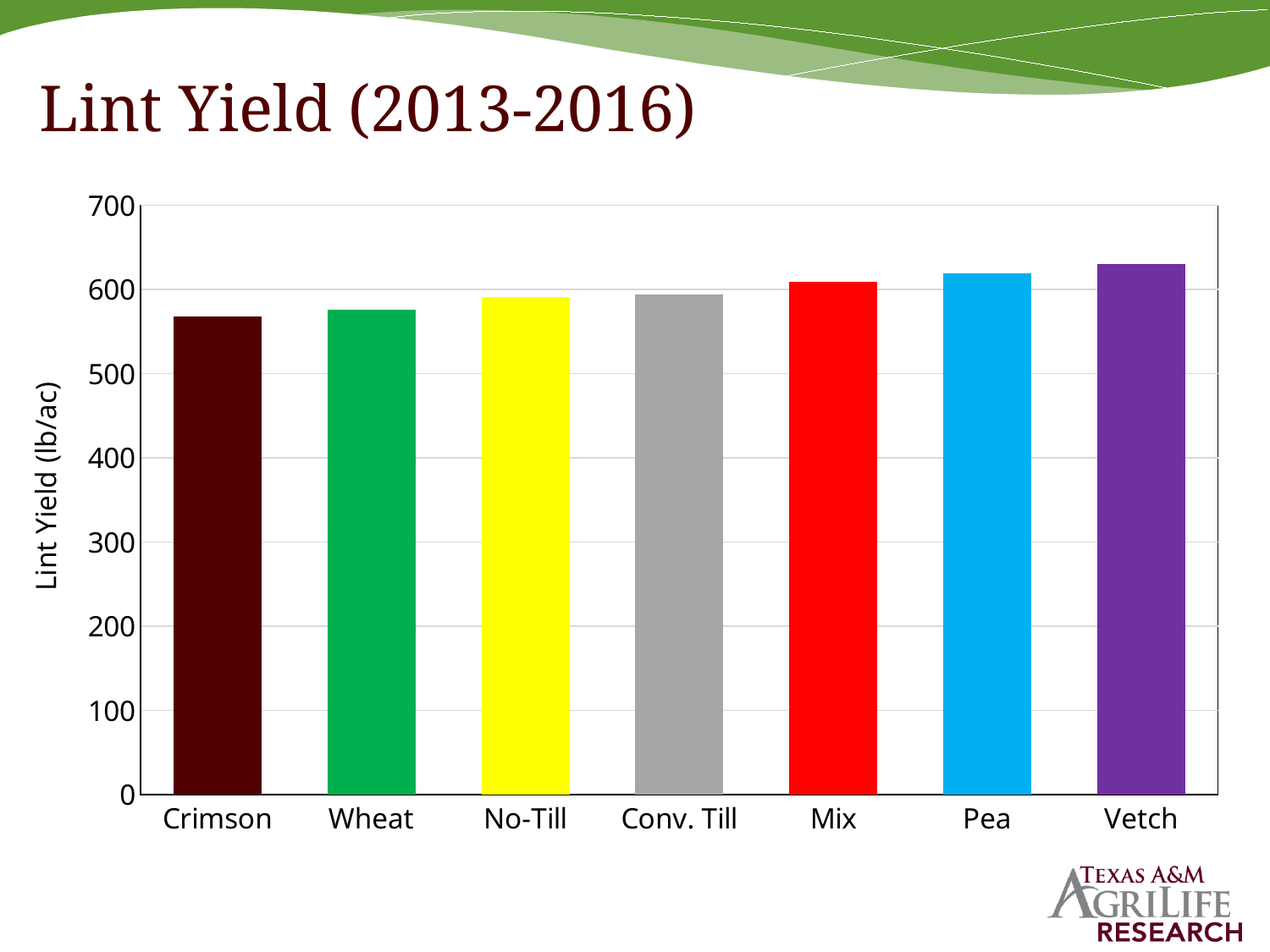
Is the lint yield for Mix greater or less than 600? greater What kind of chart is shown on the slide? bar chart Which has a higher lint yield, Crimson or Pea? Pea What is the label on the y axis of the chart? Lint Yield (lb/ac) Which category has the highest lint yield? Vetch Is the lint yield for Wheat greater or less than 600? less Which category has the lowest lint yield? Crimson Do the lint yield values rise or fall from left to right across the categories? rise How many categories are shown on the x axis of the chart? 7 Which has a higher lint yield, Wheat or Mix? Mix Is the lint yield for Crimson greater or less than 600? less